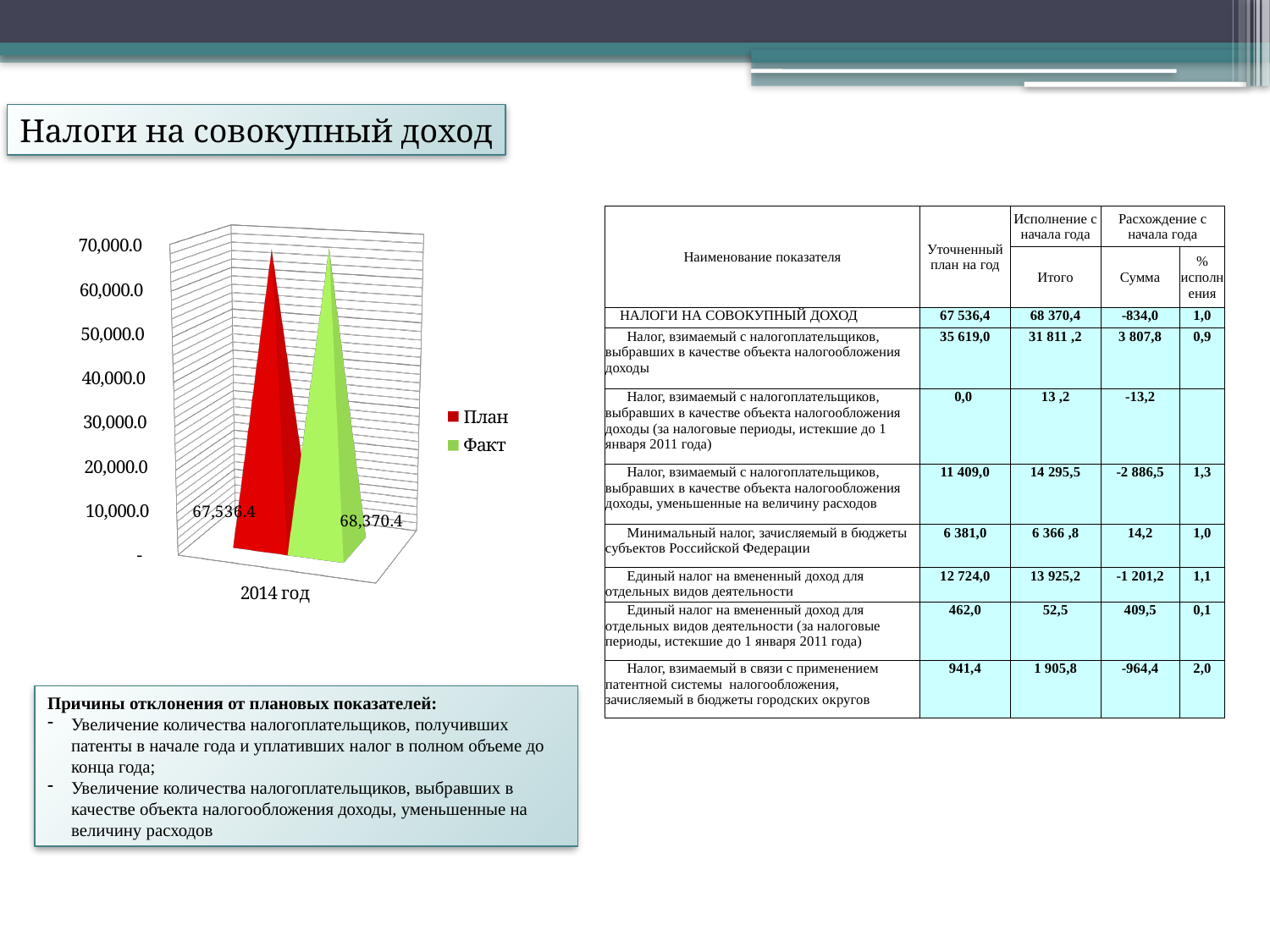
How many series does the chart legend list? 2 Is the value for Факт in 2014 год greater or less than 70,000.0? less What colour represents the Факт series in the chart? green What kind of chart is shown on the slide? bar chart What is the value of the План series for 2014 год? 67,536.4 What category label is shown on the x axis of the chart? 2014 год Which series has the larger value for 2014 год, План or Факт? Факт Is the value for План in 2014 год greater or less than 60,000.0? greater How many categories are shown on the x axis of the chart? 1 What is the value of the Факт series for 2014 год? 68,370.4 What is the difference between the Факт value and the План value for 2014 год? 834.0